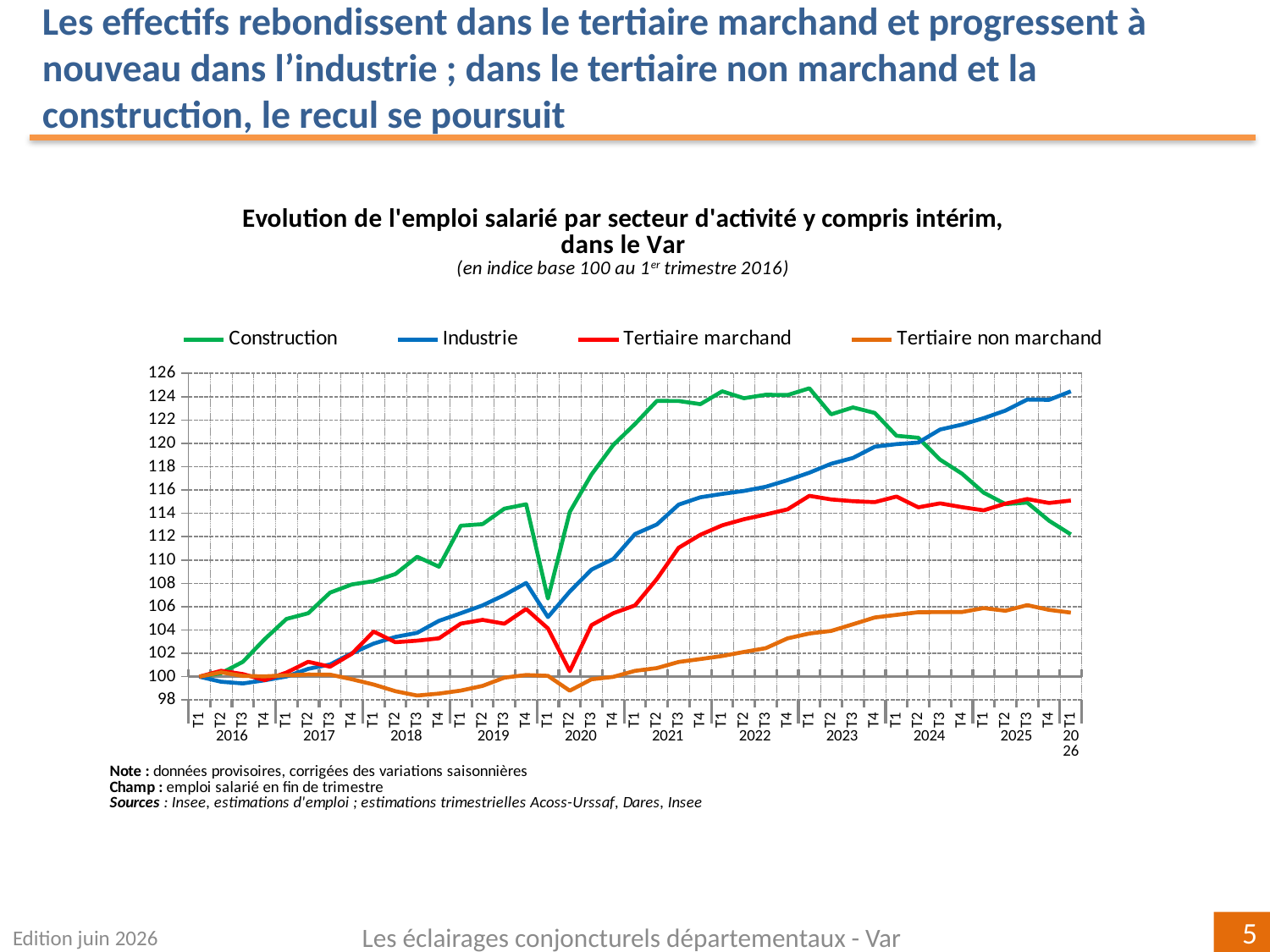
Is the value for Construction at T1 2026 greater or less than 110? greater Is the value for Tertiaire marchand at T2 2020 greater or less than 102? less Which series has the lowest value at T1 2026? Tertiaire non marchand What is the index value of all four series at T1 2016? 100 Which series has the highest value at T1 2026? Industrie Which series are listed in the legend? Construction, Industrie, Tertiaire marchand, Tertiaire non marchand Is the value for Tertiaire non marchand at T3 2018 greater or less than 100? less How many series does the legend list? 4 Does the Construction series rise or fall between T1 2022 and T1 2026? fall What kind of chart is shown on the slide? line chart At T1 2022, which is higher: Construction or Industrie? Construction